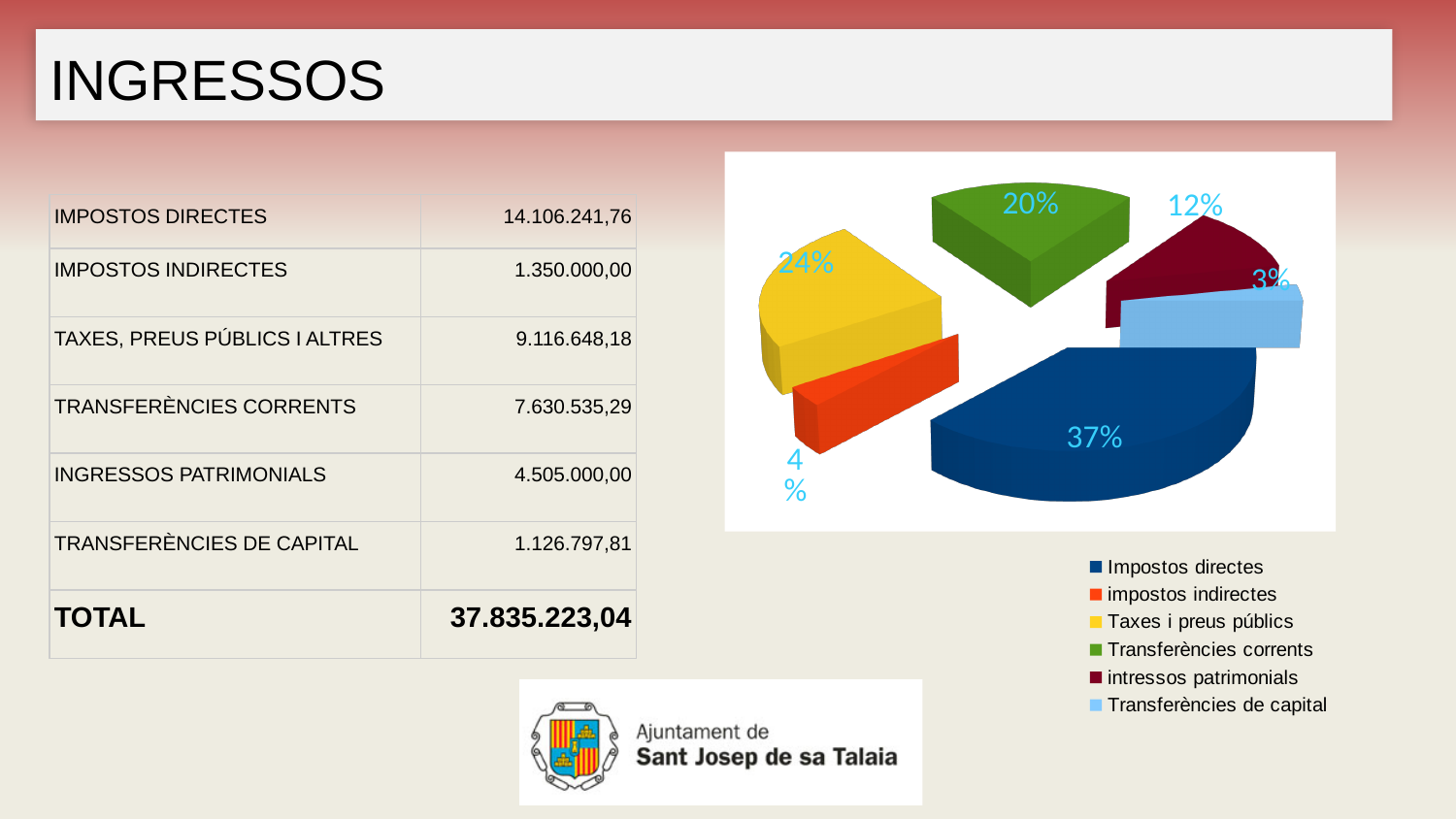
How many entries does the legend of the pie chart list? 6 What share of the pie does Impostos directes represent? 37% What colour is the Impostos directes slice in the pie chart? Dark blue What is the difference in percentage points between the Impostos directes slice and the Taxes i preus públics slice? 13 What share of the pie does Taxes i preus públics represent? 24% What kind of chart is shown on the slide? Pie chart Which slice is larger, Transferències corrents or intressos patrimonials? Transferències corrents What share of the pie does intressos patrimonials represent? 12% Which slice of the pie chart is the smallest? Transferències de capital Which slice of the pie chart is the largest? Impostos directes